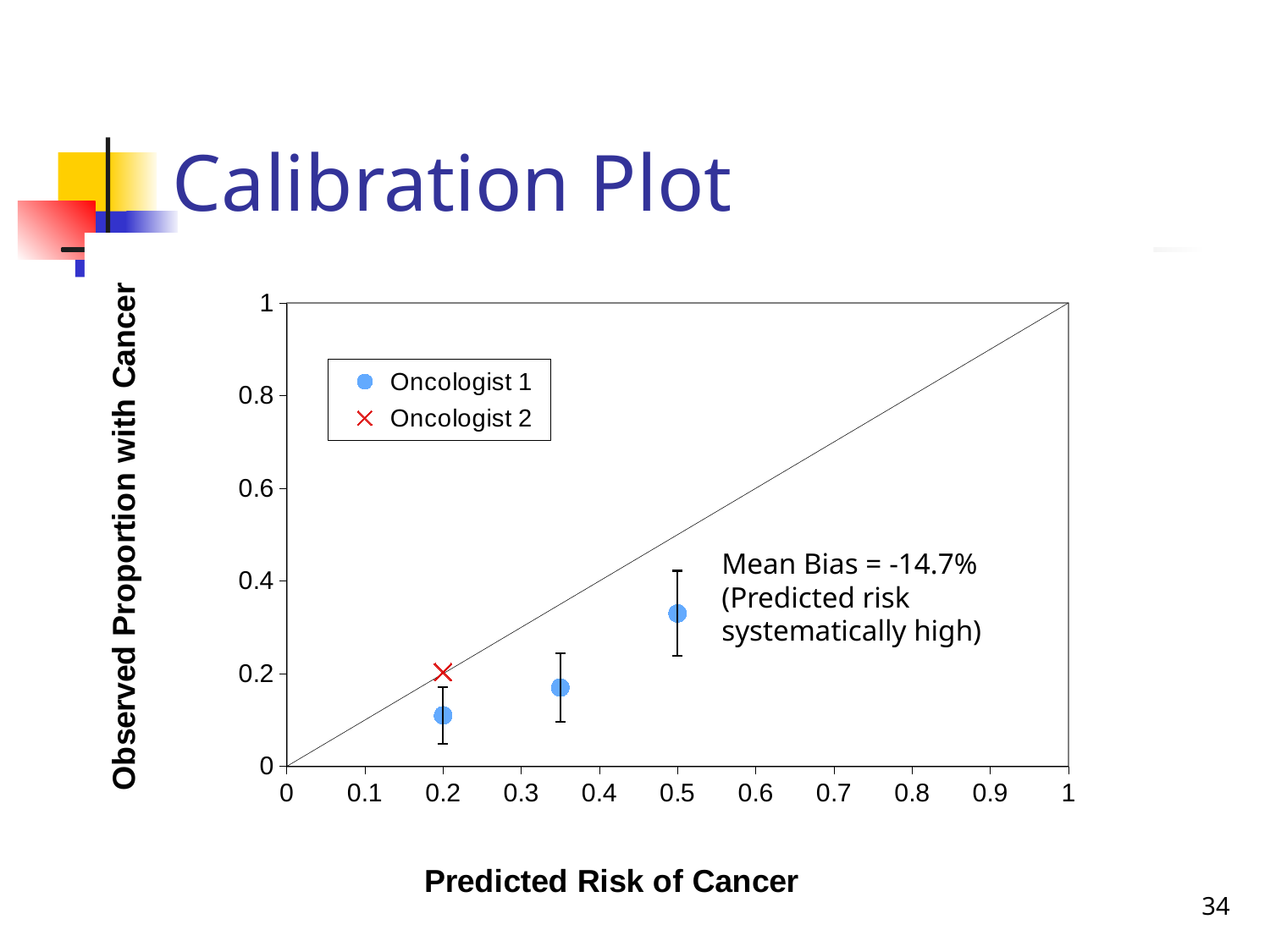
What mean bias is stated on the chart? -14.7% What marker symbol represents Oncologist 2 in the legend? a red X At which predicted risk does Oncologist 1 have the highest observed proportion with cancer? 0.5 What is the label of the x axis? Predicted Risk of Cancer Is the observed proportion for Oncologist 1 at a predicted risk of 0.2 greater or less than 0.2? less Is the observed proportion for Oncologist 1 at a predicted risk of 0.5 greater or less than 0.4? less At a predicted risk of 0.2, which has the higher observed proportion: Oncologist 1 or Oncologist 2? Oncologist 2 Do the Oncologist 1 points rise or fall as predicted risk increases along the x axis? rise How many data points are plotted for Oncologist 1? 3 How many data points are plotted for Oncologist 2? 1 How many series does the legend list? 2 What kind of chart is shown on the slide? scatter plot